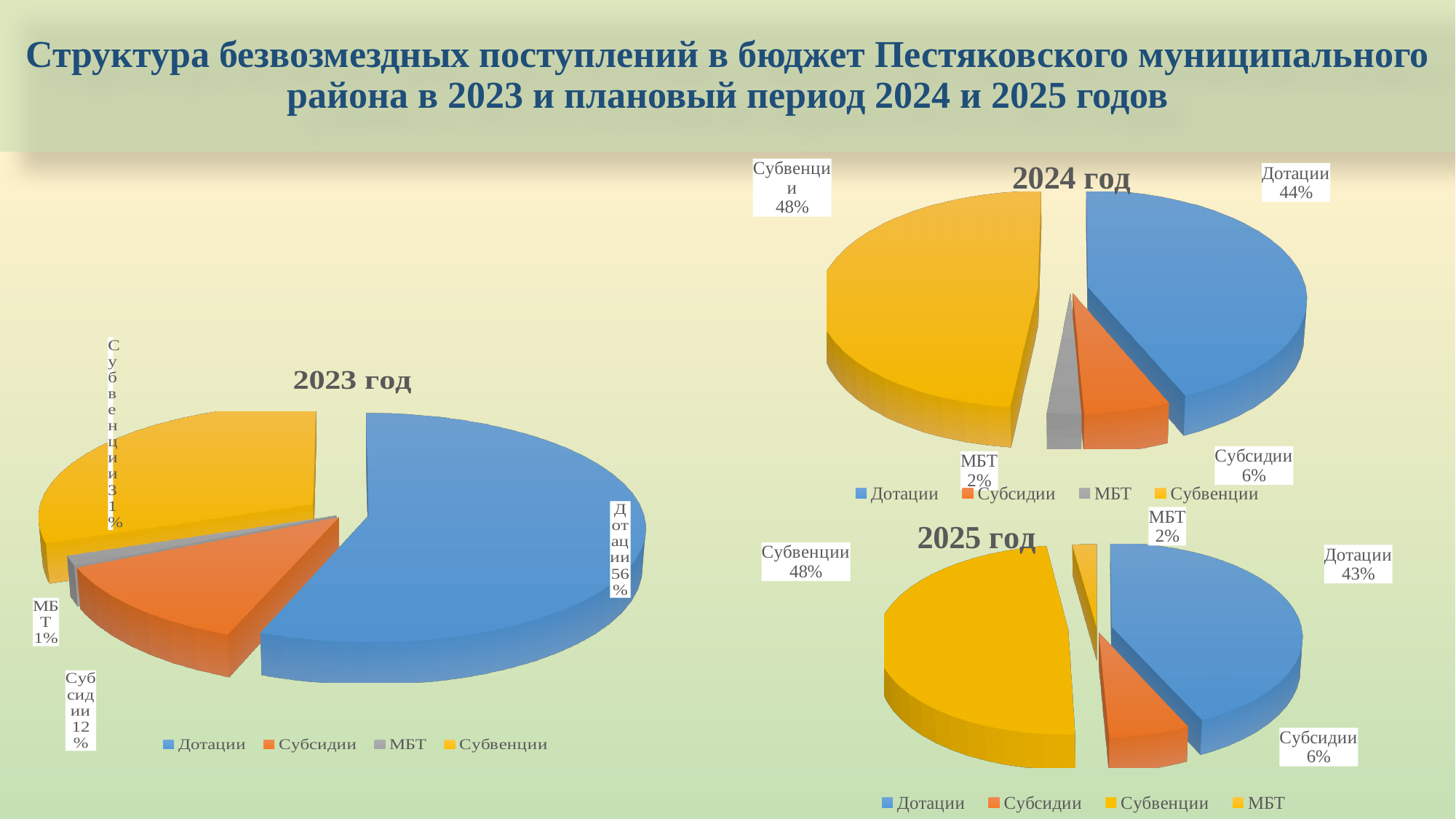
What type of chart is the "2024 год" chart? Pie chart In the "2024 год" chart, what share does МБТ have? 2% In the "2023 год" chart, what is the difference between the shares of Дотации and Субсидии? 44% In the "2023 год" chart, what share does Дотации have? 56% In the "2023 год" chart, which category has the smallest share? МБТ How many categories does the "2025 год" chart show? 4 In the "2023 год" chart, what share does Субвенции have? 31% In the "2025 год" chart, what share does Дотации have? 43% In the "2024 год" chart, which category has the largest share? Субвенции In the "2025 год" chart, which is larger, Субсидии or МБТ? Субсидии In the "2024 год" chart, what share does Субвенции have? 48% In the "2025 год" chart, what is the difference between the shares of Субвенции and Дотации? 5%